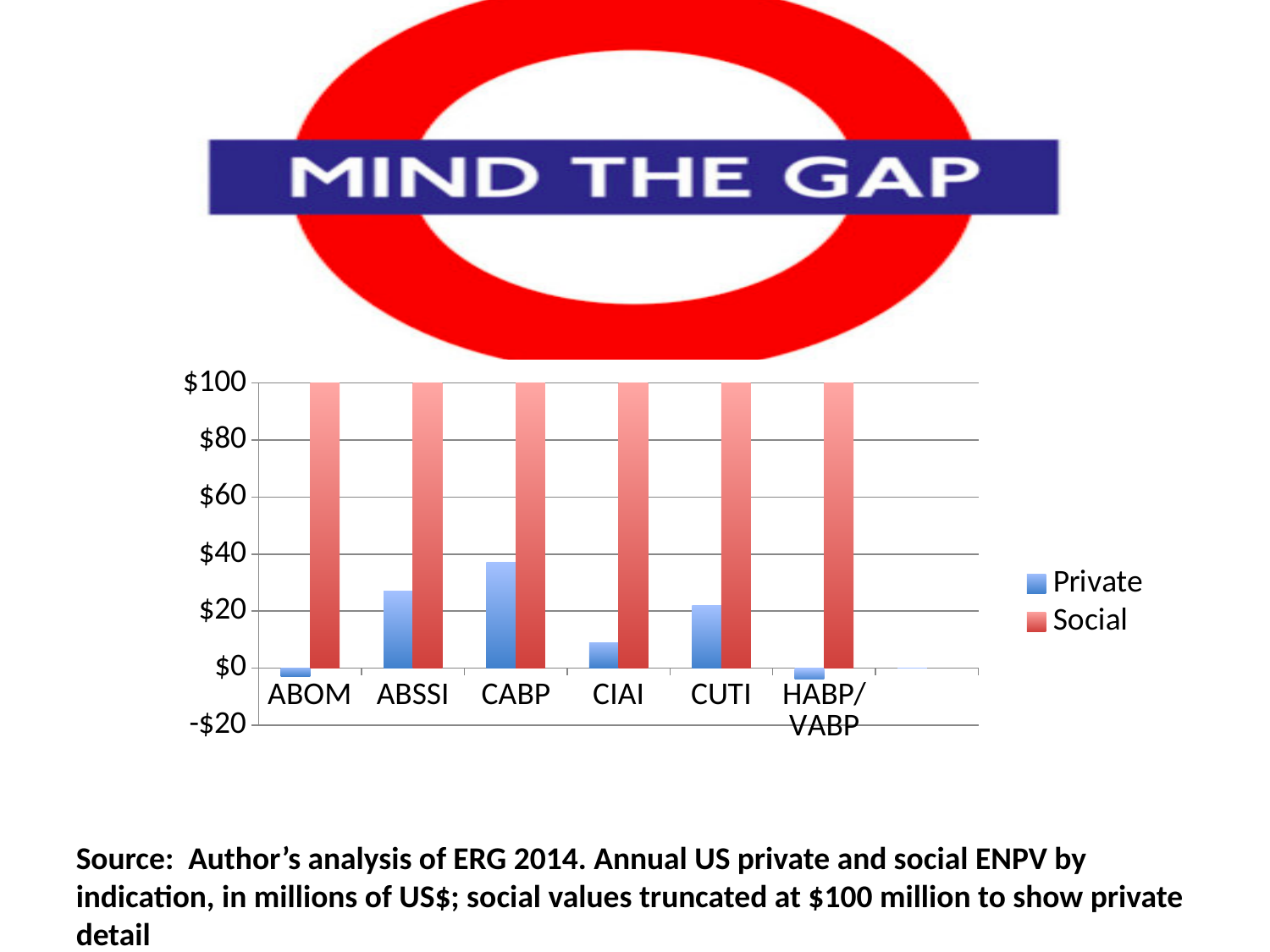
Which has the larger Private value, ABSSI or CIAI? ABSSI How many series does the legend list? 2 Is the Private value for CIAI greater or less than $20? less Which series has the taller bar in every category, Private or Social? Social Is the Private value for CABP greater or less than $20? greater Is the Private value for ABOM greater or less than $0? less Which has the larger Private value, CUTI or CABP? CABP What kind of chart is shown on the slide? Bar chart How many categories are shown on the x axis of the chart? 6 Which category has the highest Private value? CABP What colour are the Social bars in the chart? Red